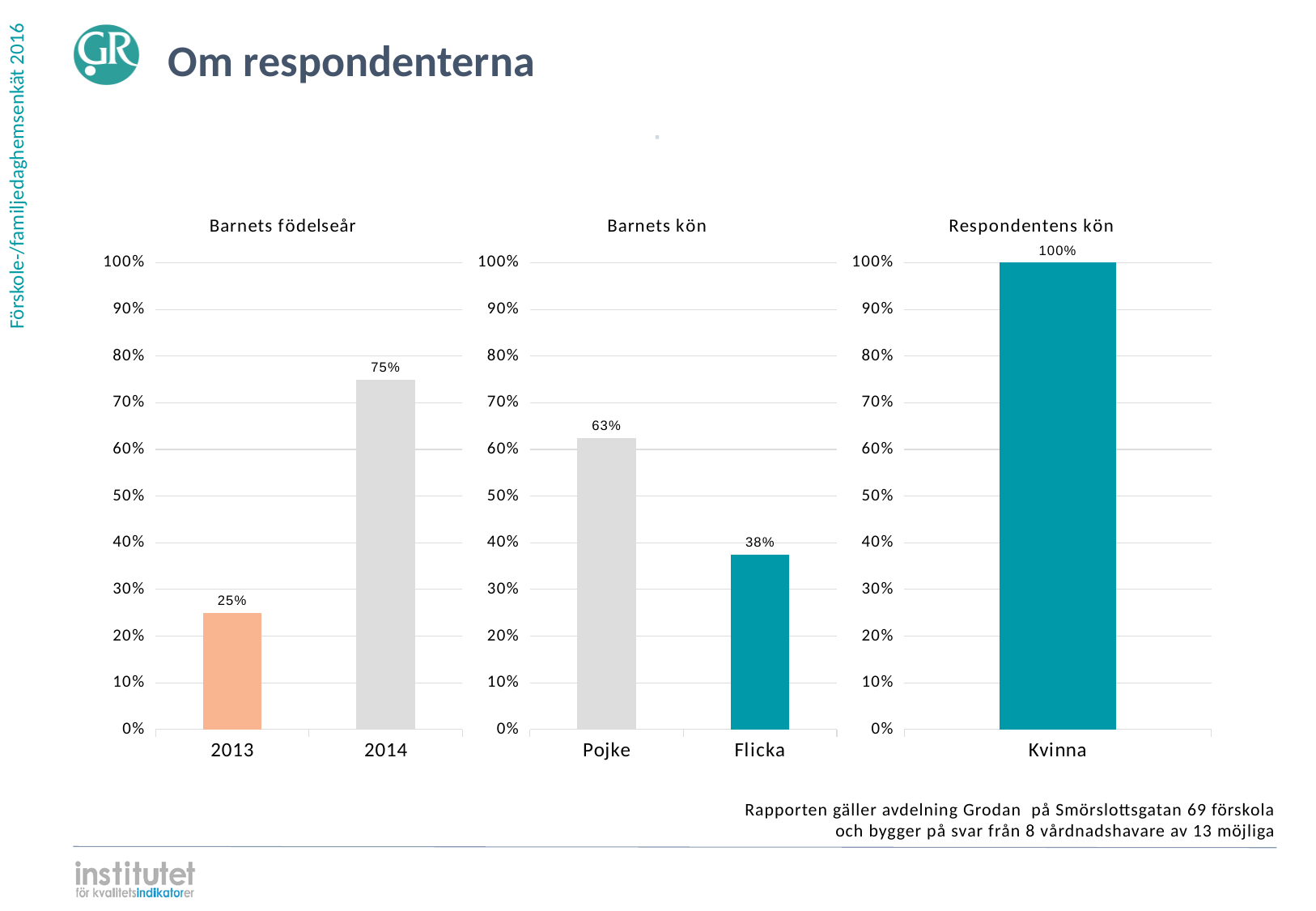
In the 'Barnets födelseår' chart, what is the value for 2013? 25% In the 'Barnets kön' chart, what is the value for Pojke? 63% In the 'Barnets kön' chart, what is the difference between the values for Pojke and Flicka? 25% In the 'Barnets kön' chart, what is the value for Flicka? 38% In the 'Barnets kön' chart, which category has the lowest value? Flicka In the 'Barnets födelseår' chart, what is the difference between the values for 2014 and 2013? 50% How many categories are shown in the 'Respondentens kön' chart? 1 In the 'Barnets födelseår' chart, which category has the highest value? 2014 In the 'Barnets kön' chart, which is larger, Pojke or Flicka? Pojke In the 'Respondentens kön' chart, what is the value for Kvinna? 100% In the 'Barnets födelseår' chart, what is the value for 2014? 75% What kind of chart is the 'Barnets kön' chart? Bar chart